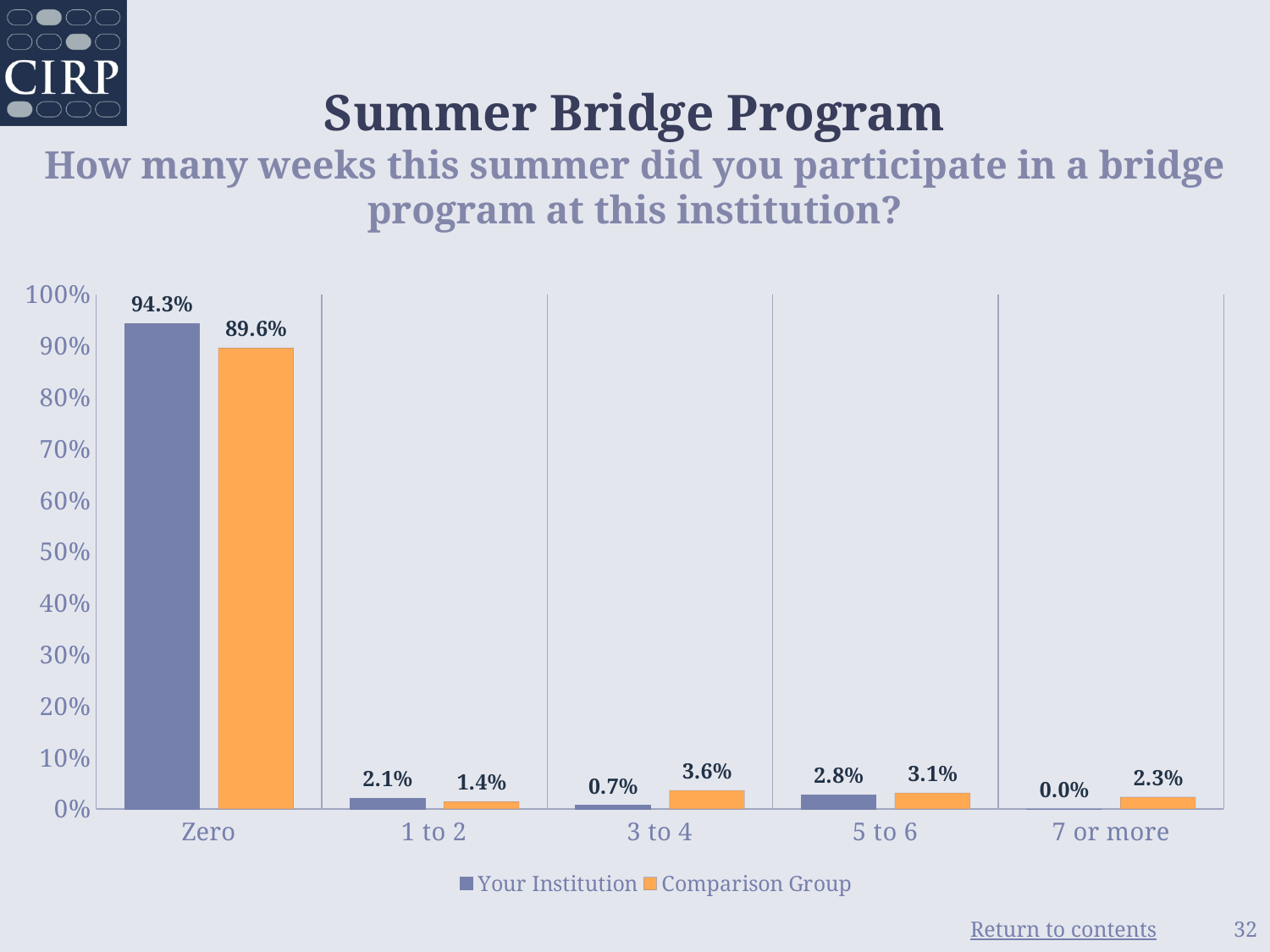
Which category has the lowest value for Your Institution? 7 or more How many series does the legend list? 2 What kind of chart is shown on the slide? Bar chart What percentage of Your Institution respondents reported Zero weeks in a bridge program? 94.3% What is the Your Institution value for 7 or more weeks? 0.0% What is the Comparison Group value for the 3 to 4 weeks category? 3.6% Which series is shown in orange? Comparison Group How many categories are shown on the x axis? 5 What is the difference between Your Institution and the Comparison Group for the Zero category? 4.7% Which category has the highest value for the Comparison Group? Zero For the 5 to 6 weeks category, which series has the larger value, Your Institution or Comparison Group? Comparison Group Is the Comparison Group value for Zero weeks greater or less than 80%? greater